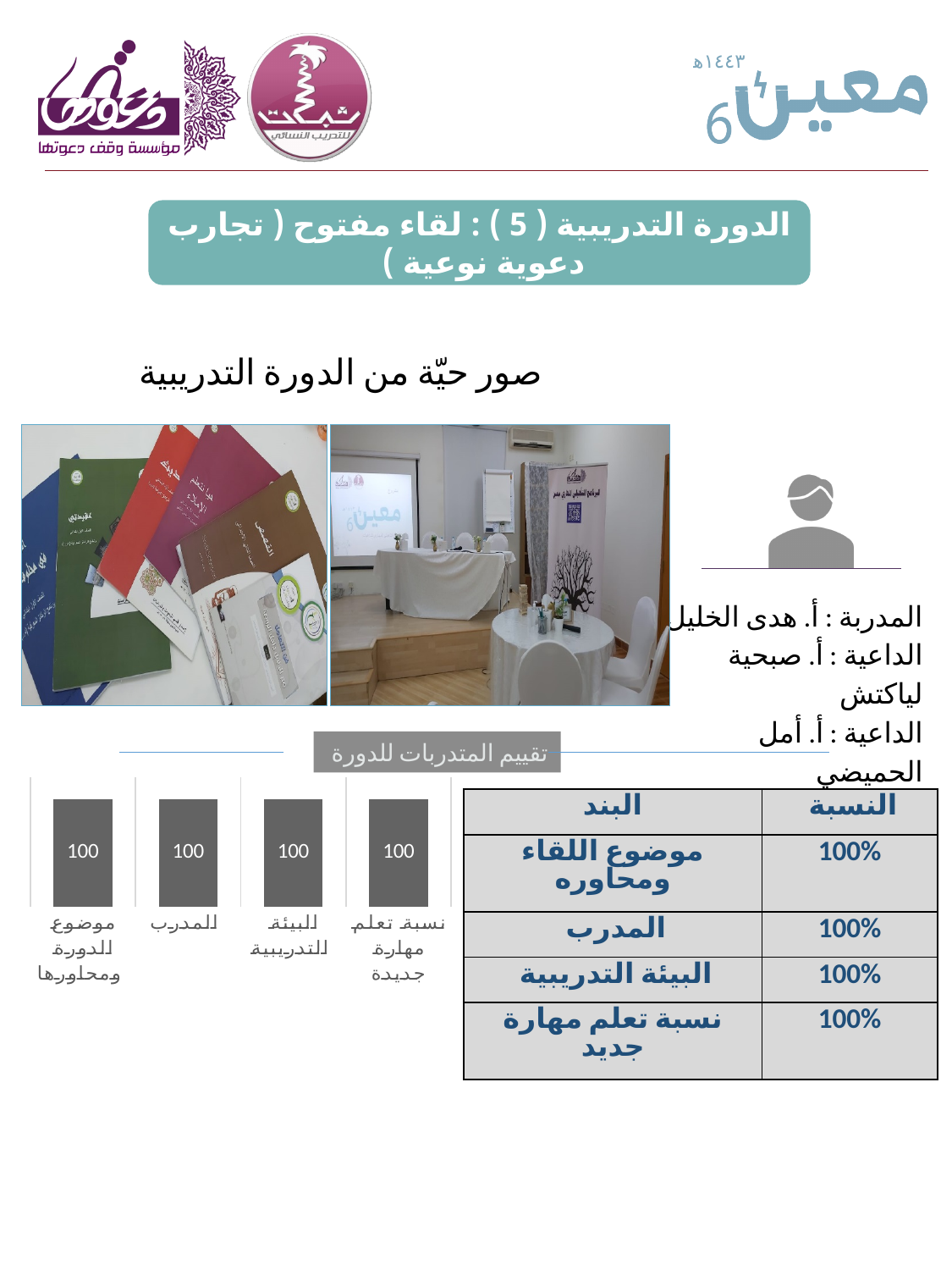
Is the value for المدرب greater or less than 50? greater What is the value of the bar for البيئة التدريبية? 100 What is the title of the chart on the slide? تقييم المتدربات للدورة What is the difference between the values for المدرب and البيئة التدريبية? 0 Do the bar values rise, fall, or stay the same across the categories? stay the same What type of chart is shown on the slide? bar chart What is the value of the bar for موضوع الدورة ومحاورها? 100 What is the value of the bar for نسبة تعلم مهارة جديدة? 100 What is the value of the bar for المدرب? 100 What colour are the bars in the chart? grey What is the sum of all four bar values in the chart? 400 How many bars does the chart show? 4